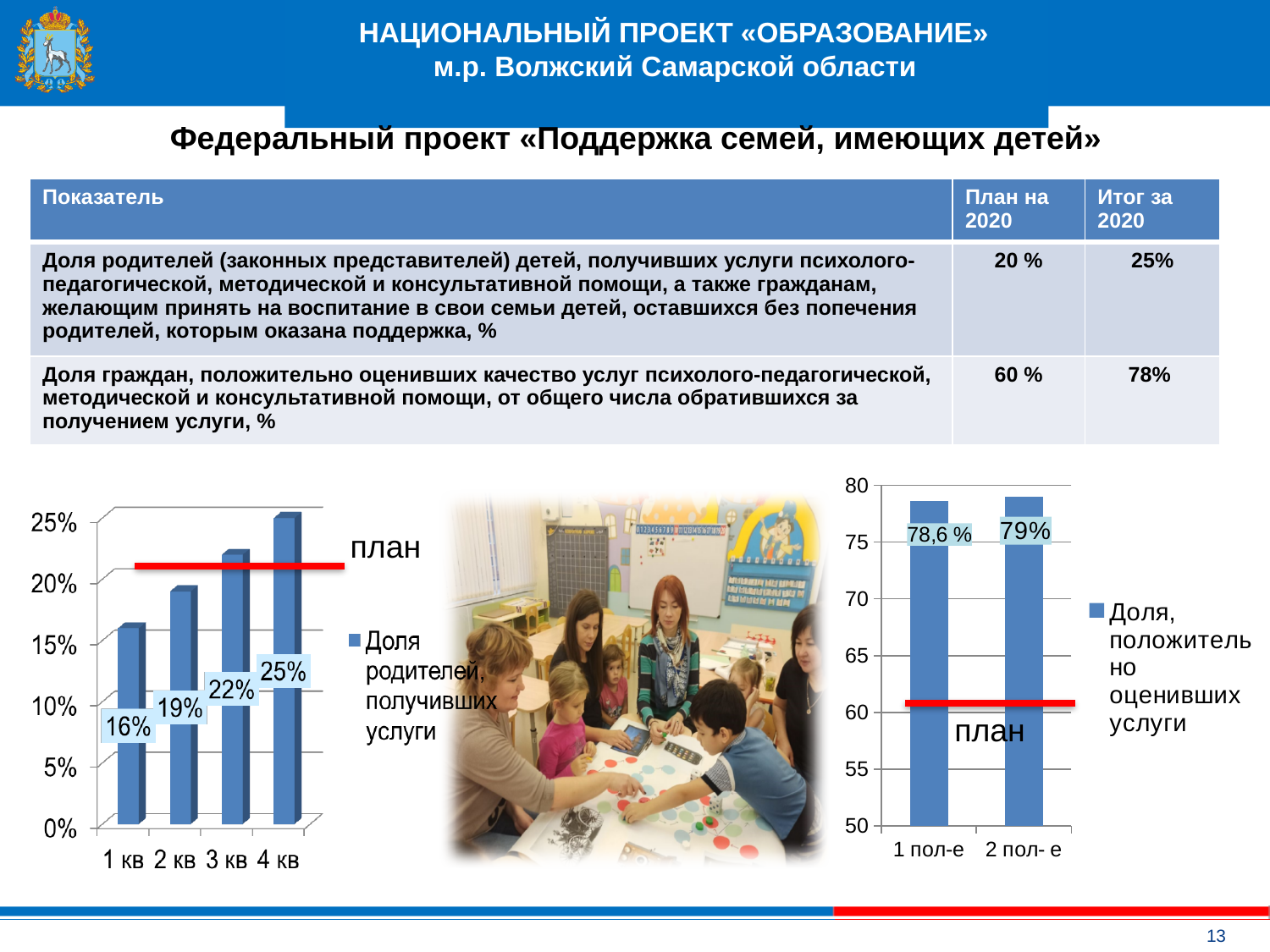
On the right chart, is the value for 1 пол-е greater or less than 70? greater On the right chart, what is the value for 2 пол- е? 79% What kind of chart is the right chart? bar chart On the left chart, do the values rise or fall from 1 кв to 4 кв? rise On the left chart, what is the difference between the values for 4 кв and 1 кв? 9% On the left chart, what is the legend entry for the blue bars? Доля родителей, получивших услуги On the left chart, how many quarters are plotted? 4 On the right chart, what is the value for 1 пол-е? 78,6 % On the left chart, which quarter has the lowest value? 1 кв On the left chart, what is the value for 1 кв? 16% On the left chart, which quarter has the highest value? 4 кв On the left chart, what is the value for 3 кв? 22%